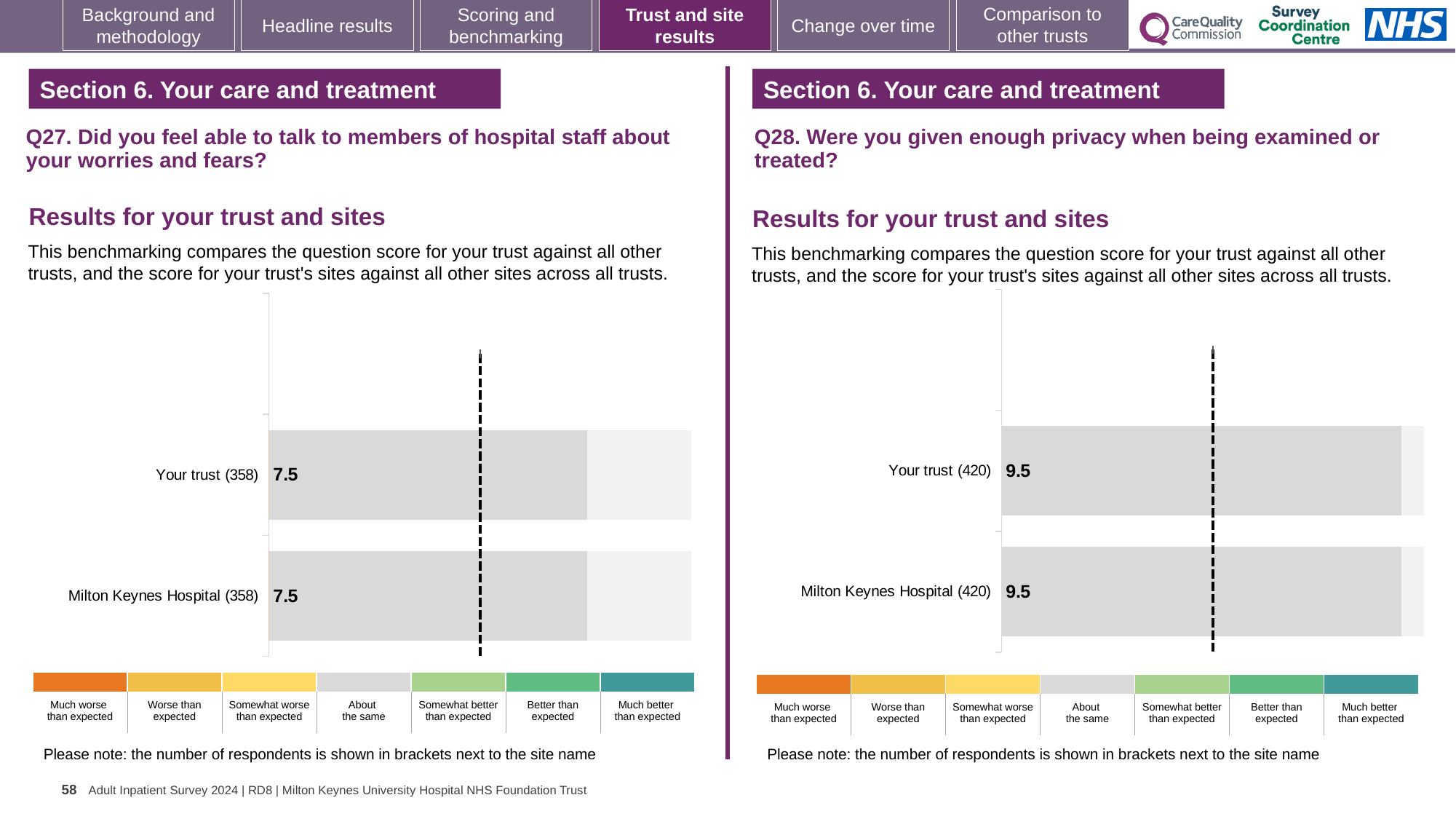
How many categories are shown in the Q27 chart on the left? 2 In the Q27 chart on the left, what is the score for Your trust? 7.5 What kind of chart is the Q27 chart on the left? Bar chart In the Q28 chart on the right, how many respondents are shown in brackets next to Milton Keynes Hospital? 420 In the Q28 chart on the right, what is the difference between the score for Your trust and the score for Milton Keynes Hospital? 0 In the Q27 chart on the left, how many respondents are shown in brackets next to Your trust? 358 How many bars are plotted in the Q28 chart on the right? 2 In the Q27 chart on the left, what is the difference between the score for Your trust and the score for Milton Keynes Hospital? 0 In the Q27 chart on the left, what is the score for Milton Keynes Hospital? 7.5 In the Q28 chart on the right, what is the score for Milton Keynes Hospital? 9.5 In the Q28 chart on the right, what is the score for Your trust? 9.5